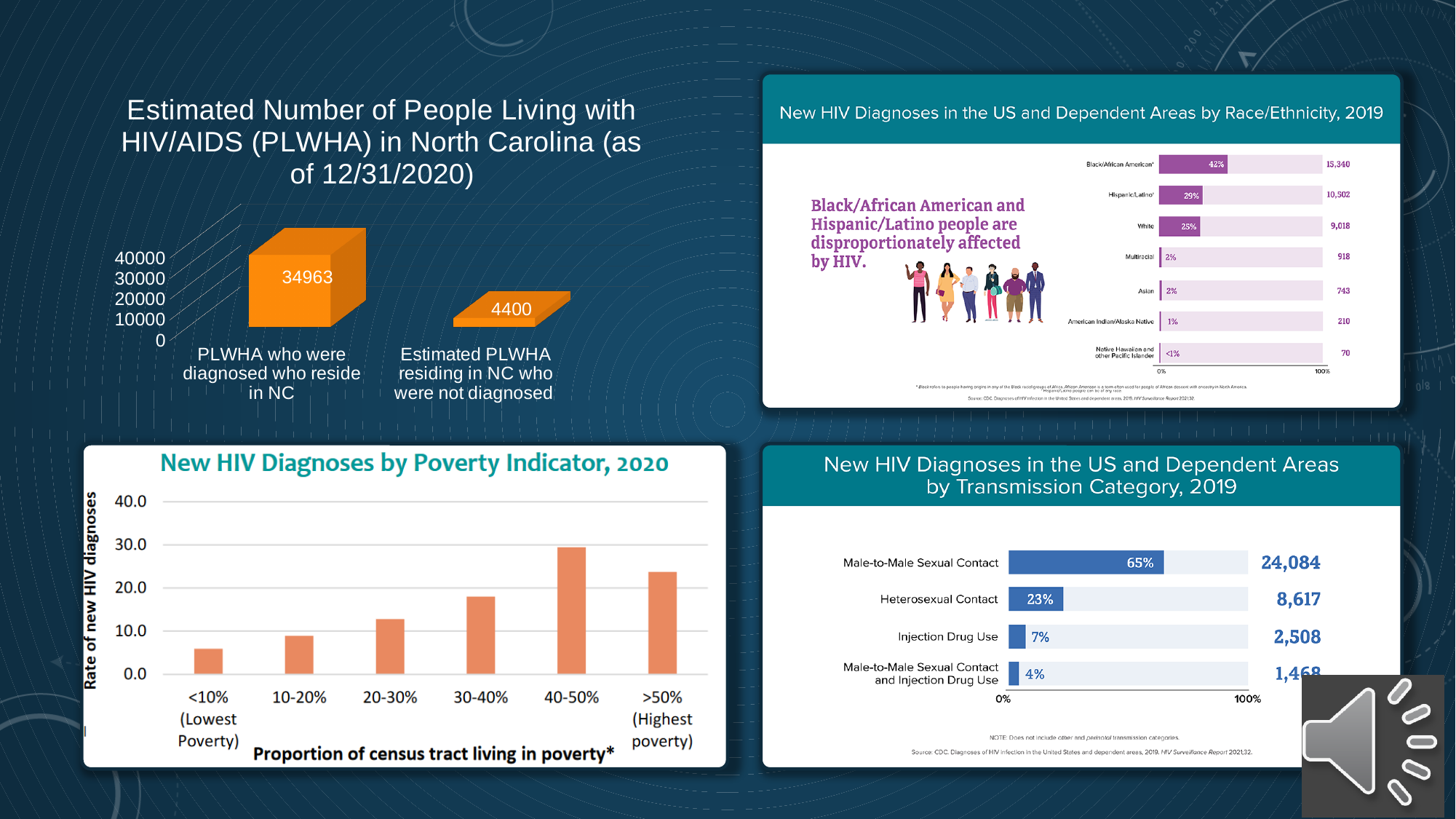
In the chart titled 'New HIV Diagnoses by Poverty Indicator, 2020', is the value for the 30-40% category greater or less than 10.0? greater In the chart titled 'New HIV Diagnoses by Poverty Indicator, 2020', what kind of chart is shown? Bar chart In the chart titled 'New HIV Diagnoses in the US and Dependent Areas by Race/Ethnicity, 2019', what percentage is shown for Hispanic/Latino? 29% In the chart titled 'New HIV Diagnoses in the US and Dependent Areas by Race/Ethnicity, 2019', how many race/ethnicity categories are shown? 7 In the chart titled 'New HIV Diagnoses by Poverty Indicator, 2020', which poverty category has the highest rate of new HIV diagnoses? 40-50% In the chart titled 'New HIV Diagnoses in the US and Dependent Areas by Race/Ethnicity, 2019', what number is shown for White? 9,018 In the chart titled 'New HIV Diagnoses in the US and Dependent Areas by Transmission Category, 2019', what number is shown for Heterosexual Contact? 8,617 In the chart titled 'Estimated Number of People Living with HIV/AIDS (PLWHA) in North Carolina (as of 12/31/2020)', what is the value for PLWHA who were diagnosed who reside in NC? 34963 In the chart titled 'Estimated Number of People Living with HIV/AIDS (PLWHA) in North Carolina (as of 12/31/2020)', what is the difference between the diagnosed and not diagnosed values? 30563 In the chart titled 'Estimated Number of People Living with HIV/AIDS (PLWHA) in North Carolina (as of 12/31/2020)', what is the value for Estimated PLWHA residing in NC who were not diagnosed? 4400 In the chart titled 'New HIV Diagnoses in the US and Dependent Areas by Transmission Category, 2019', what percentage is shown for Injection Drug Use? 7% In the chart titled 'New HIV Diagnoses in the US and Dependent Areas by Race/Ethnicity, 2019', which race/ethnicity has the highest number of new diagnoses? Black/African American